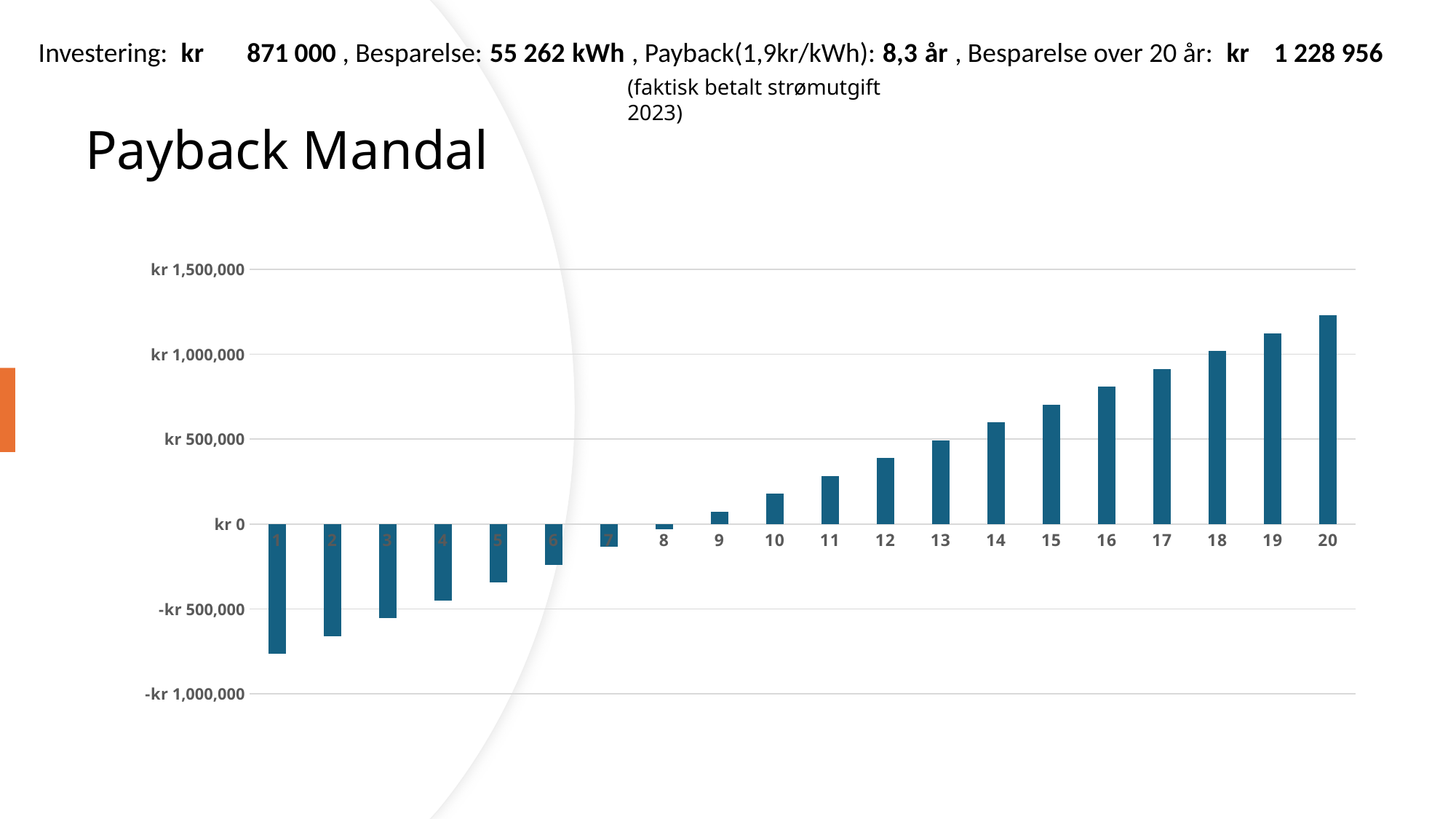
How many bars (years) are plotted on the chart? 20 Which year has the highest value on the chart? 20 What is the title of the chart? Payback Mandal Which is larger, the value for year 19 or the value for year 20? year 20 Is the value for year 20 greater or less than kr 1,000,000? greater What kind of chart is shown on the slide? bar chart Is the value for year 1 greater or less than -kr 500,000? less Which year has the lowest value on the chart? 1 Is the value for year 14 greater or less than kr 500,000? greater Which is larger, the value for year 12 or the value for year 15? year 15 Do the values generally rise or fall from year 1 to year 20? rise